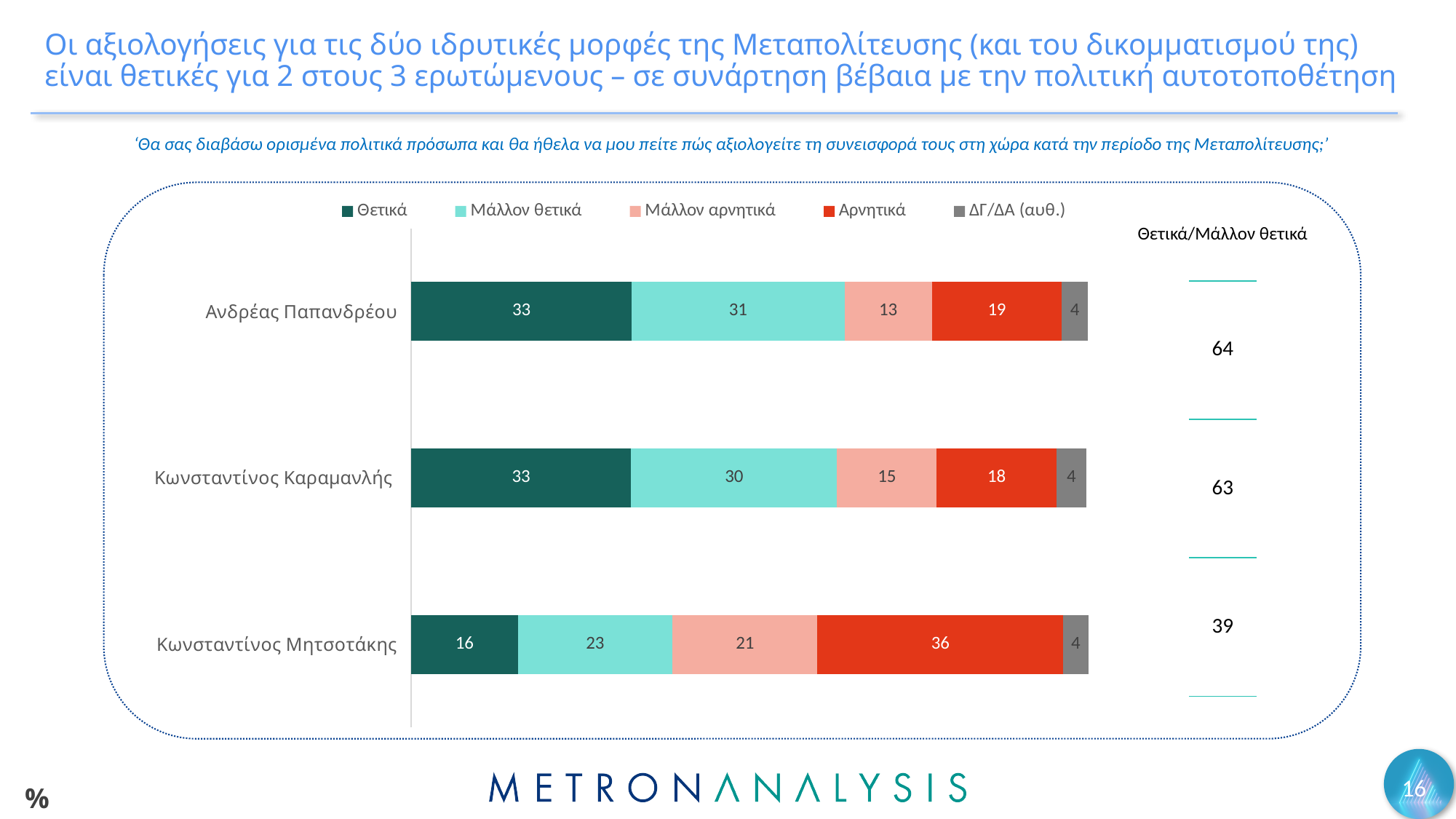
Which person has the highest Αρνητικά value? Κωνσταντίνος Μητσοτάκης What is the Θετικά value for Ανδρέας Παπανδρέου? 33 What is the difference between the Μάλλον θετικά values for Ανδρέας Παπανδρέου and Κωνσταντίνος Μητσοτάκης? 8 What is the Θετικά/Μάλλον θετικά combined figure shown for Κωνσταντίνος Μητσοτάκης? 39 What is the Μάλλον αρνητικά value for Κωνσταντίνος Καραμανλής? 15 Which is larger: the Αρνητικά value for Ανδρέας Παπανδρέου or for Κωνσταντίνος Καραμανλής? Ανδρέας Παπανδρέου What kind of chart is shown on the slide? Stacked bar chart How many people (categories) are shown in the chart? 3 What is the total of the stacked bar for Κωνσταντίνος Καραμανλής? 100 Which person has the lowest Θετικά value? Κωνσταντίνος Μητσοτάκης How many series does the legend list? 5 What is the Αρνητικά value for Κωνσταντίνος Μητσοτάκης? 36